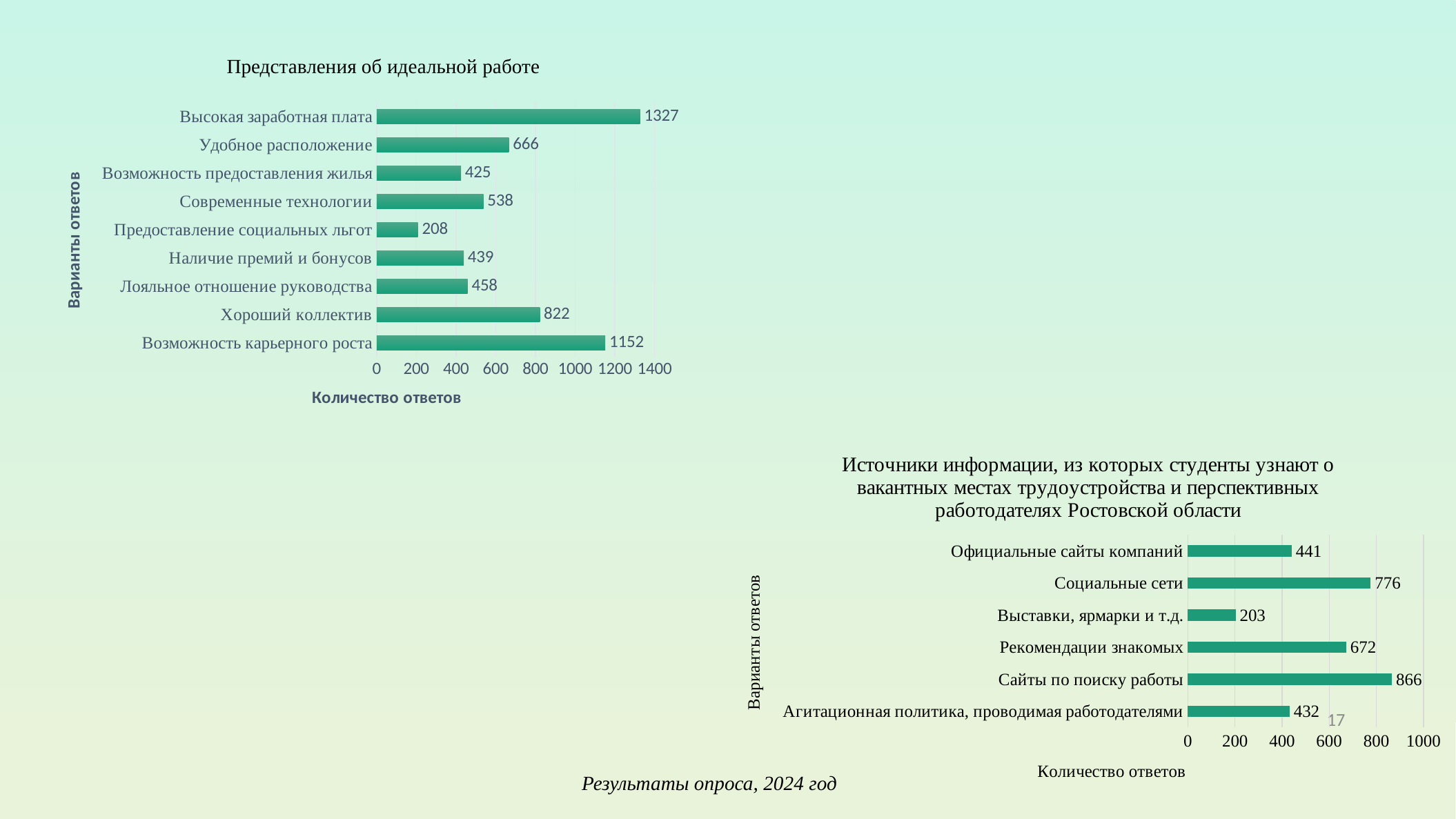
In the chart 'Представления об идеальной работе', how many categories are shown? 9 In the chart 'Источники информации...' (bottom right), what is the difference between 'Сайты по поиску работы' and 'Рекомендации знакомых'? 194 In the chart 'Представления об идеальной работе', which category has the lowest value? Предоставление социальных льгот In the chart 'Представления об идеальной работе', which is larger: 'Удобное расположение' or 'Современные технологии'? Удобное расположение In the chart 'Представления об идеальной работе', what is the difference between 'Высокая заработная плата' and 'Возможность карьерного роста'? 175 In the chart 'Источники информации...' (bottom right), which category has the highest value? Сайты по поиску работы In the chart 'Источники информации, из которых студенты узнают о вакантных местах трудоустройства и перспективных работодателях Ростовской области', what is the value for 'Социальные сети'? 776 What type of chart is 'Представления об идеальной работе'? Bar chart In the chart 'Представления об идеальной работе', which category has the highest value? Высокая заработная плата In the chart 'Источники информации...' (bottom right), how many categories are shown? 6 In the chart 'Представления об идеальной работе', what is the value for 'Хороший коллектив'? 822 In the chart 'Источники информации...' (bottom right), which category has the lowest value? Выставки, ярмарки и т.д.